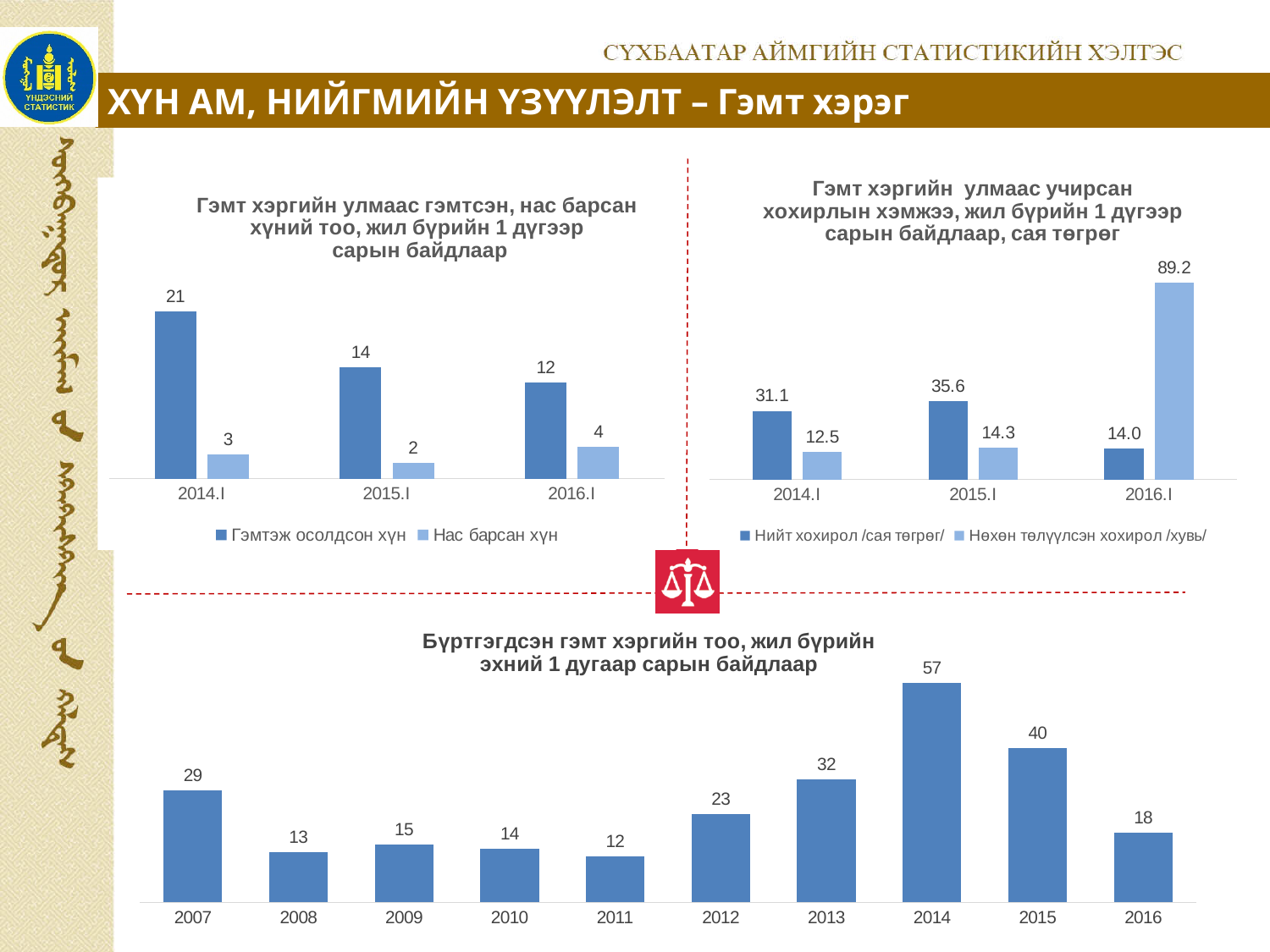
In the bottom chart (Бүртгэгдсэн гэмт хэргийн тоо), what is the difference between the values for 2014 and 2015? 17 In the bottom chart (Бүртгэгдсэн гэмт хэргийн тоо), what is the value for 2014? 57 In the bottom chart (Бүртгэгдсэн гэмт хэргийн тоо), is the value for 2007 larger or smaller than the value for 2016? larger In the bottom chart (Бүртгэгдсэн гэмт хэргийн тоо), how many years are shown on the x axis? 10 In the bottom chart (Бүртгэгдсэн гэмт хэргийн тоо), which year has the lowest value? 2011 In the top-right chart (Гэмт хэргийн улмаас учирсан хохирлын хэмжээ), what is the value for Нөхөн төлүүлсэн хохирол /хувь/ in 2016.I? 89.2 In the top-left chart (Гэмт хэргийн улмаас гэмтсэн, нас барсан хүний тоо), what is the value for Гэмтэж осолдсон хүн in 2014.I? 21 In the top-left chart (Гэмт хэргийн улмаас гэмтсэн, нас барсан хүний тоо), what is the value for Нас барсан хүн in 2016.I? 4 What kind of chart is the top-right chart (Гэмт хэргийн улмаас учирсан хохирлын хэмжээ)? bar chart In the top-right chart (Гэмт хэргийн улмаас учирсан хохирлын хэмжээ), what is the difference between Нийт хохирол in 2015.I and 2014.I? 4.5 In the top-left chart (Гэмт хэргийн улмаас гэмтсэн, нас барсан хүний тоо), how many series does the legend list? 2 In the bottom chart (Бүртгэгдсэн гэмт хэргийн тоо), which year has the highest value? 2014